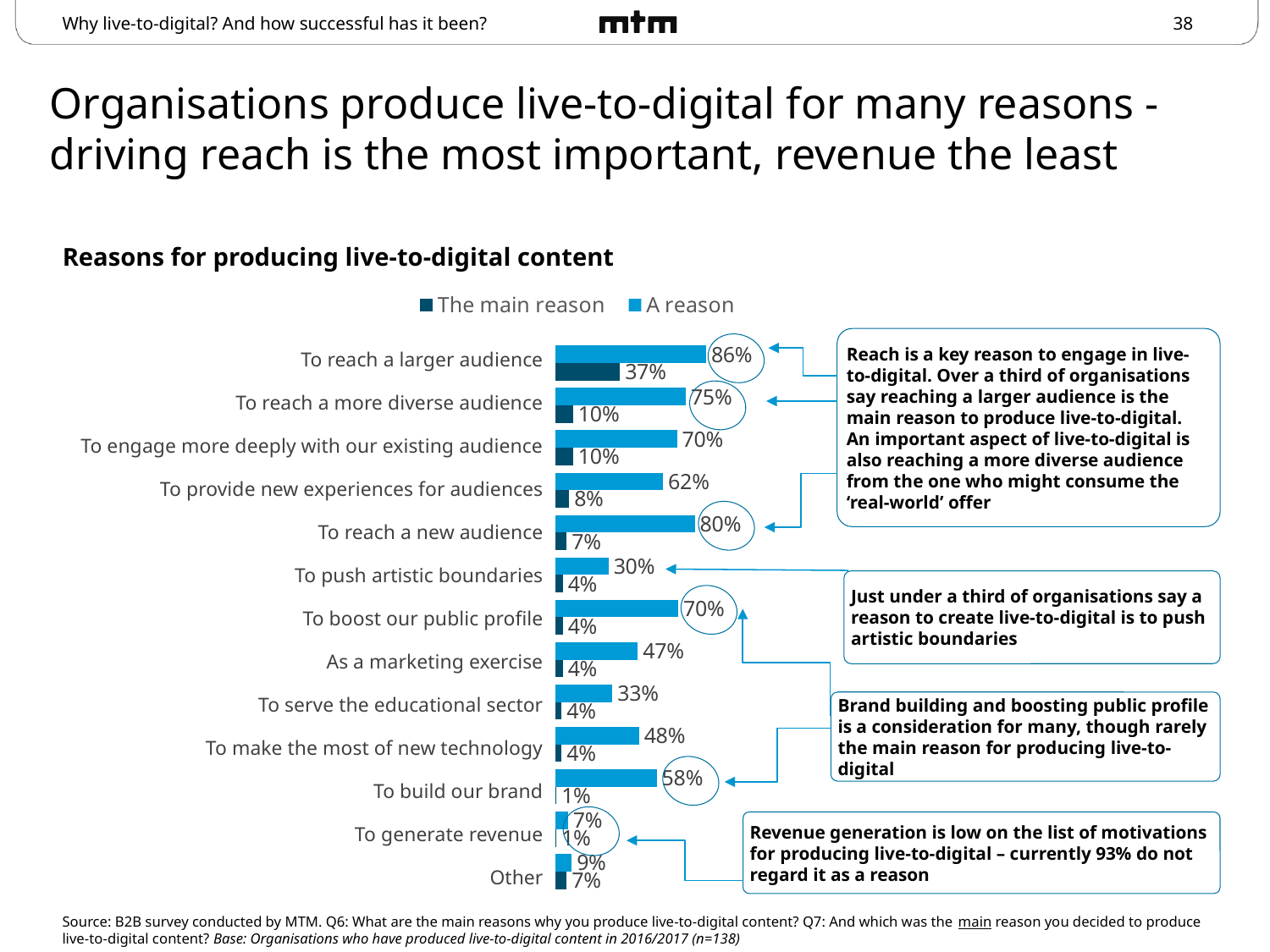
What percentage of organisations say 'To reach a larger audience' is the main reason? 37% What is the difference between the 'A reason' values for 'To reach a new audience' and 'To push artistic boundaries'? 50% Which legend entry is shown in the darker blue colour? The main reason Which reason has the lowest 'A reason' value? To generate revenue How many series does the legend list? 2 Which reason has the highest 'A reason' value? To reach a larger audience How many reasons (categories) are plotted in the chart? 13 What is the 'A reason' value for 'To build our brand'? 58% What kind of chart is shown under 'Reasons for producing live-to-digital content'? Bar chart What is the 'The main reason' value for 'Other'? 7% What percentage of organisations cite 'To reach a larger audience' as a reason? 86% Which has a higher 'A reason' value: 'As a marketing exercise' or 'To make the most of new technology'? To make the most of new technology